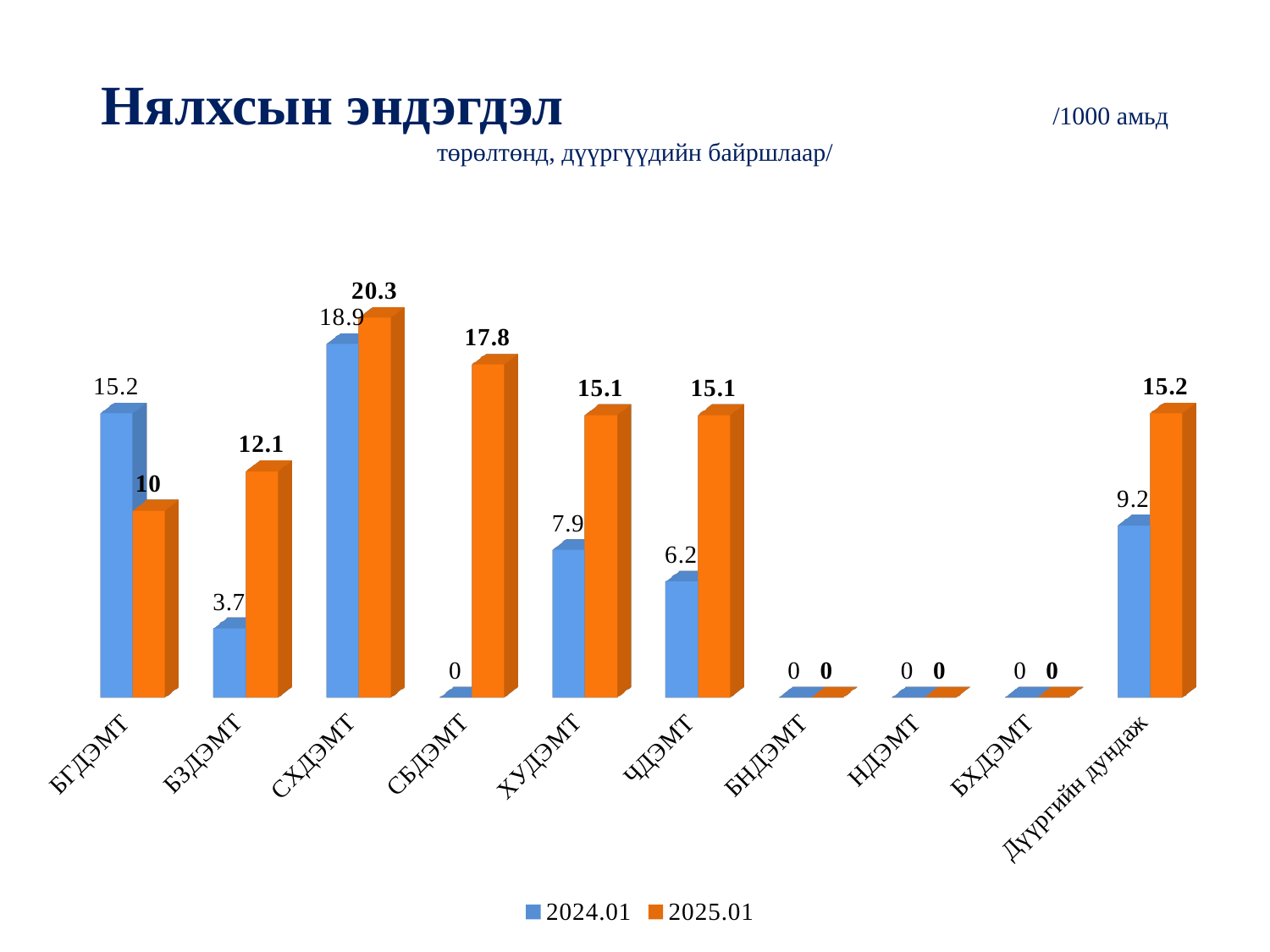
What is the 2024.01 value for БЗДЭМТ? 3.7 How many series does the legend list? 2 Which category has the highest 2024.01 value? СХДЭМТ Which is larger for ХУДЭМТ, the 2024.01 value or the 2025.01 value? 2025.01 What is the difference between the 2024.01 and 2025.01 values for БГДЭМТ? 5.2 What is the 2025.01 value for СБДЭМТ? 17.8 How many categories are shown on the x axis? 10 What is the 2024.01 value for Дүүргийн дундаж? 9.2 What is the 2025.01 value for СХДЭМТ? 20.3 What kind of chart is shown on the slide? Bar chart Which category has the highest 2025.01 value? СХДЭМТ What is the difference between the 2025.01 and 2024.01 values for БЗДЭМТ? 8.4